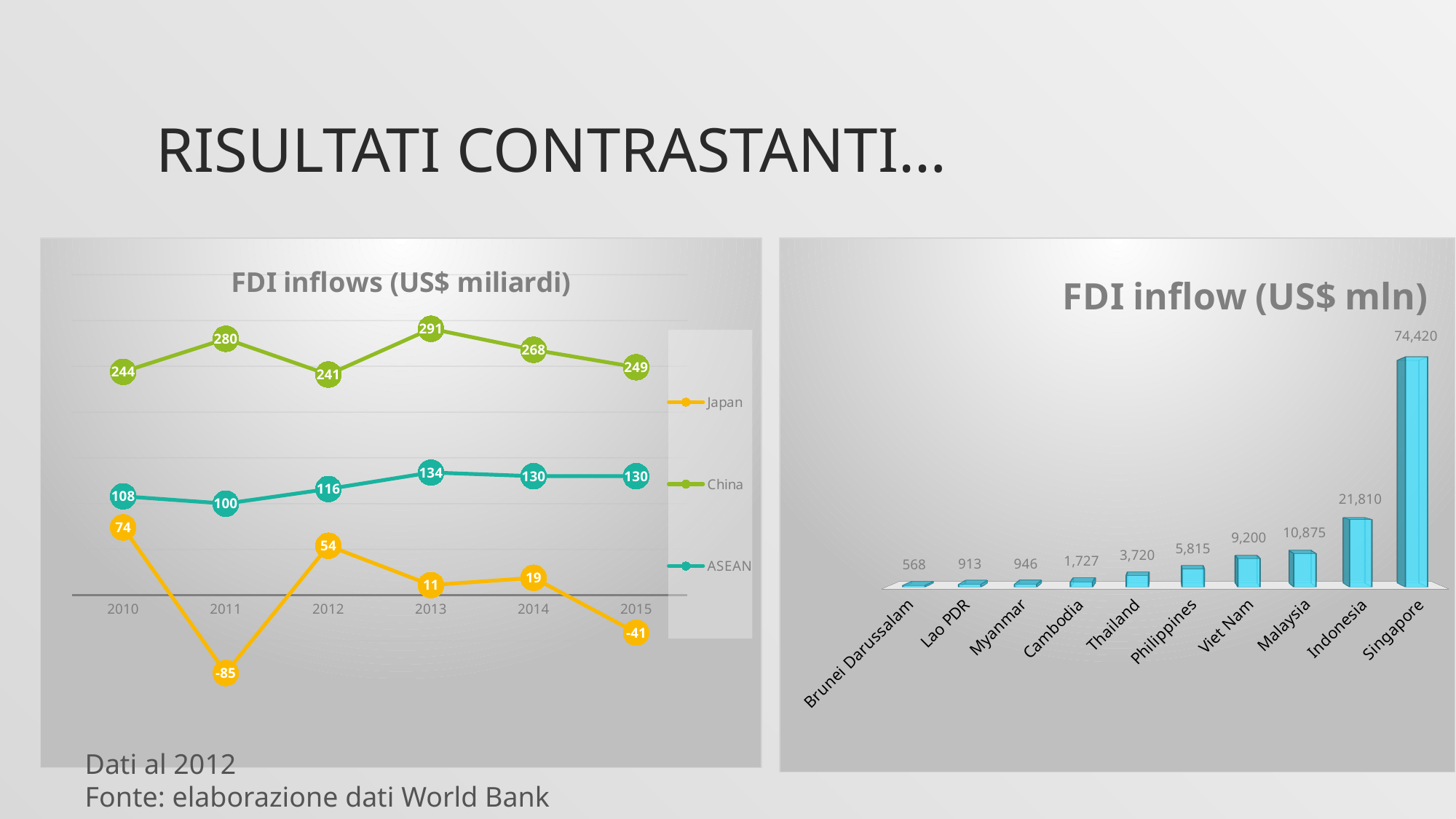
In the 'FDI inflow (US$ mln)' chart, what is the value for Thailand? 3,720 How many countries are shown in the 'FDI inflow (US$ mln)' chart? 10 What kind of chart is the 'FDI inflows (US$ miliardi)' chart? line chart How many series does the legend of the 'FDI inflows (US$ miliardi)' chart list? 3 In the 'FDI inflows (US$ miliardi)' chart, in which year is the China series highest? 2013 In the 'FDI inflows (US$ miliardi)' chart, what is the value for Japan in 2011? -85 In the 'FDI inflows (US$ miliardi)' chart, in which year is the Japan series lowest? 2011 In the 'FDI inflow (US$ mln)' chart, which country has the lowest value? Brunei Darussalam In the 'FDI inflow (US$ mln)' chart, which country has the highest value? Singapore In the 'FDI inflows (US$ miliardi)' chart, what is the value for China in 2013? 291 In the 'FDI inflows (US$ miliardi)' chart, what is the value for ASEAN in 2015? 130 In the 'FDI inflows (US$ miliardi)' chart, what is the difference between China and ASEAN in 2010? 136